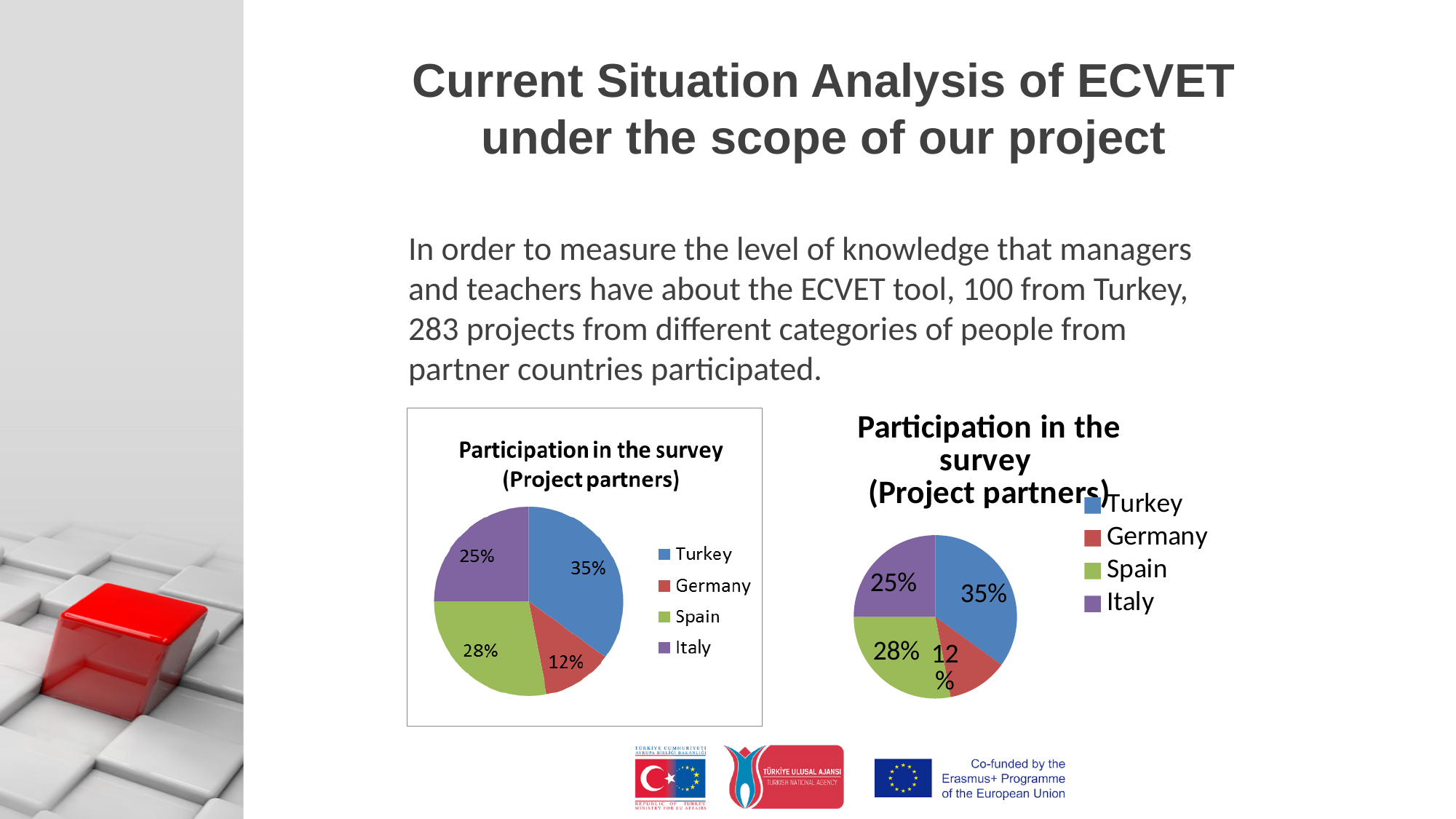
How many countries are shown in the left pie chart? 4 What is the title of the left chart? Participation in the survey (Project partners) In the left pie chart, which country has the largest share? Turkey In the right pie chart, what share of participation is shown for Germany? 12% In the left pie chart, what is the difference between the shares of Turkey and Germany? 23% In the right pie chart, which colour represents Spain? Green In the left pie chart, what share of participation is shown for Turkey? 35% In the right pie chart, what share of participation is shown for Italy? 25% In the right pie chart, which country has the smallest share? Germany In the right pie chart, which has a larger share, Spain or Italy? Spain In the left pie chart, what share of participation is shown for Spain? 28% What type of chart is the chart on the right? Pie chart